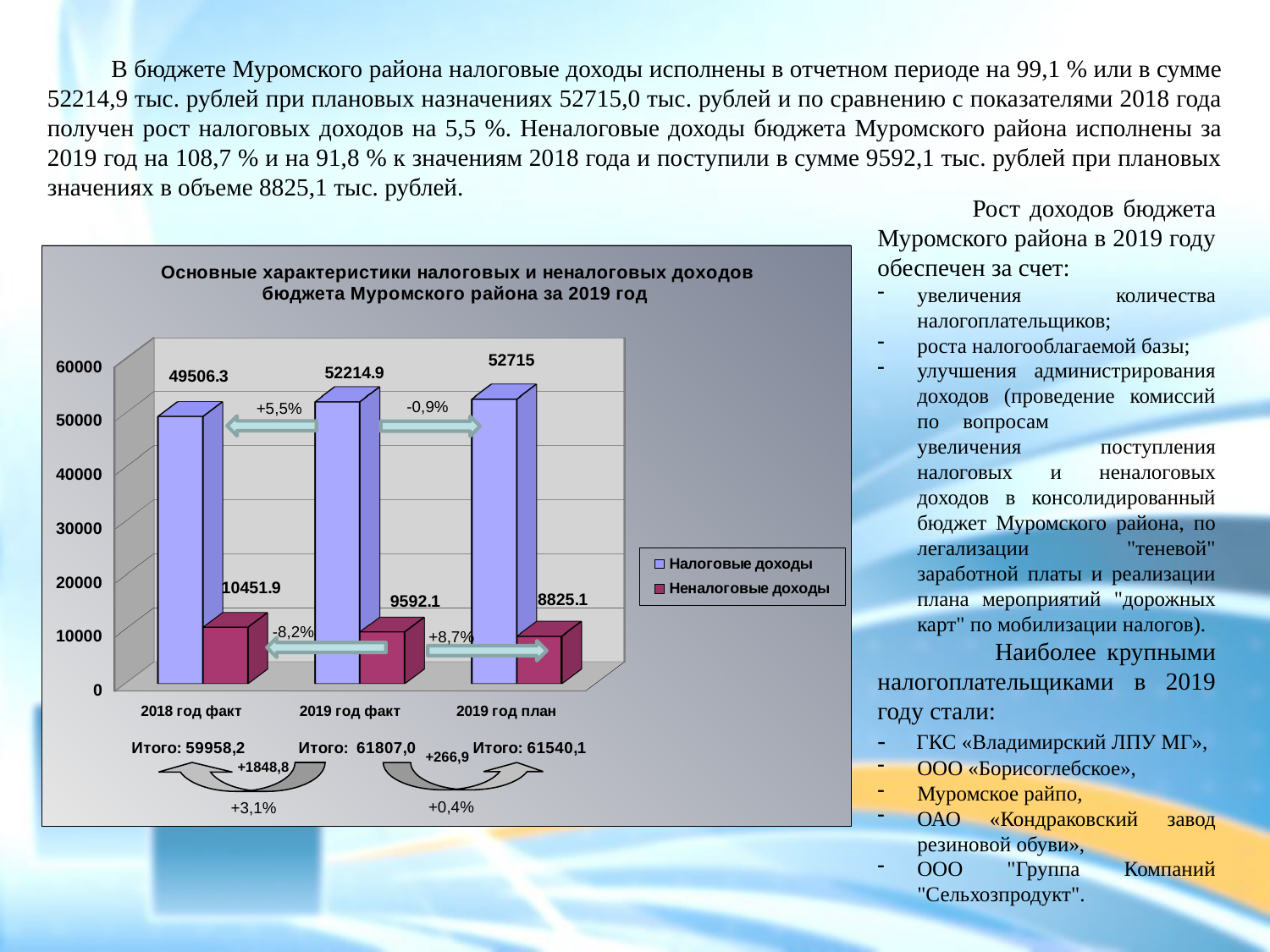
What is the total (Итого) shown for 2019 год факт? 61807,0 What is the value of Налоговые доходы for 2019 год факт? 52214.9 Is the value of Неналоговые доходы for 2019 год план greater or less than 10000? less What kind of chart is shown on the slide? bar chart What is the value of Неналоговые доходы for 2018 год факт? 10451.9 Which category has the highest value for Налоговые доходы? 2019 год план What is the difference between Налоговые доходы for 2019 год факт and 2018 год факт? 2708.6 How many series does the legend list? 2 How many categories are shown on the x axis? 3 What is the value of Налоговые доходы for 2019 год план? 52715 Which category has the lowest value for Неналоговые доходы? 2019 год план Which is larger: Неналоговые доходы for 2018 год факт or for 2019 год факт? 2018 год факт